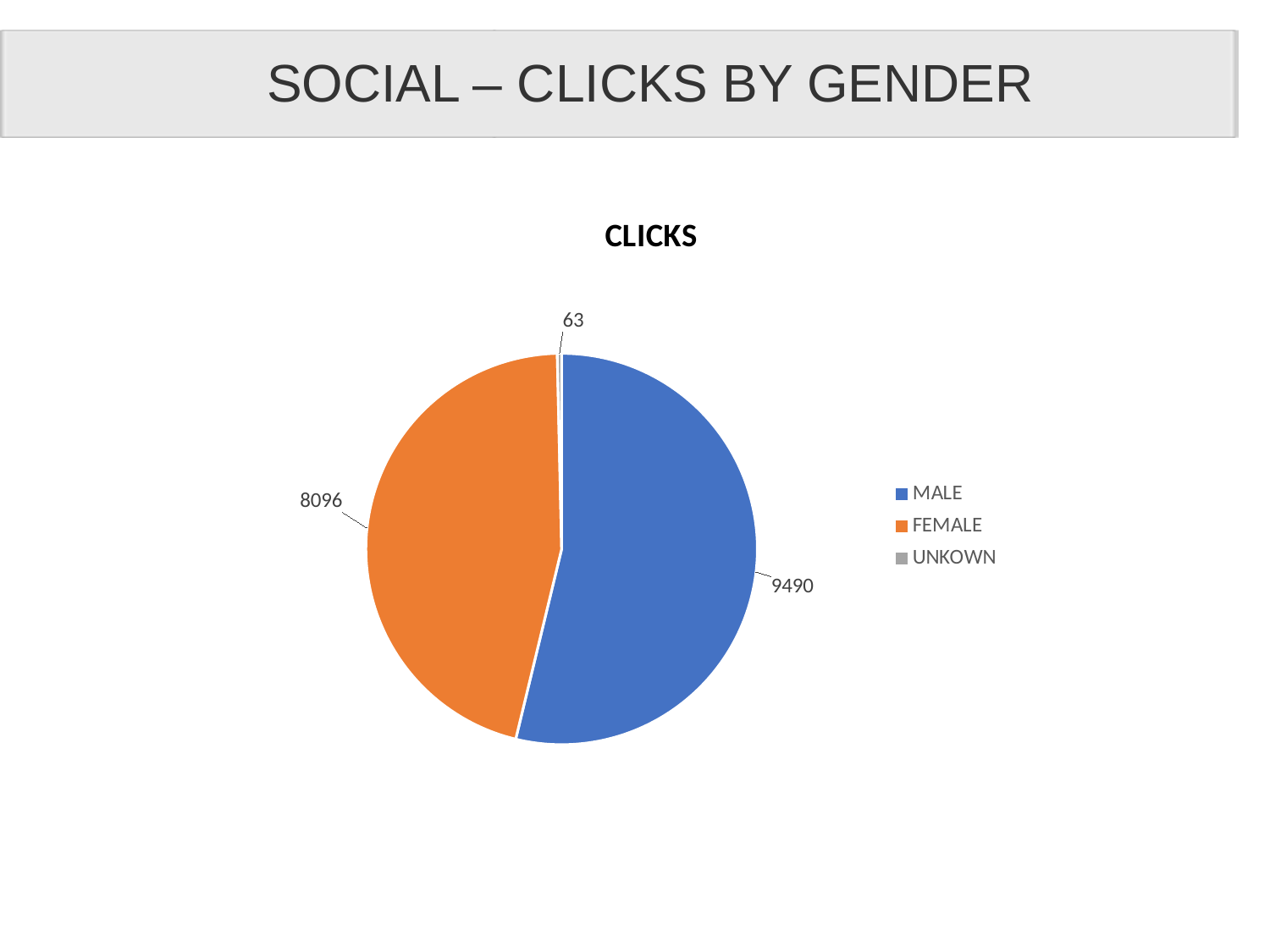
What is the number of clicks for UNKOWN? 63 Which category has the highest number of clicks? MALE How many categories does the pie chart show? 3 What is the difference in clicks between MALE and FEMALE? 1394 What is the number of clicks for FEMALE? 8096 What is the total number of clicks across all categories? 17649 What is the title of the chart? CLICKS What type of chart is shown on the slide? Pie chart What is the number of clicks for MALE? 9490 Which colour represents FEMALE in the pie chart? Orange Which has more clicks, FEMALE or UNKOWN? FEMALE Which category has the lowest number of clicks? UNKOWN